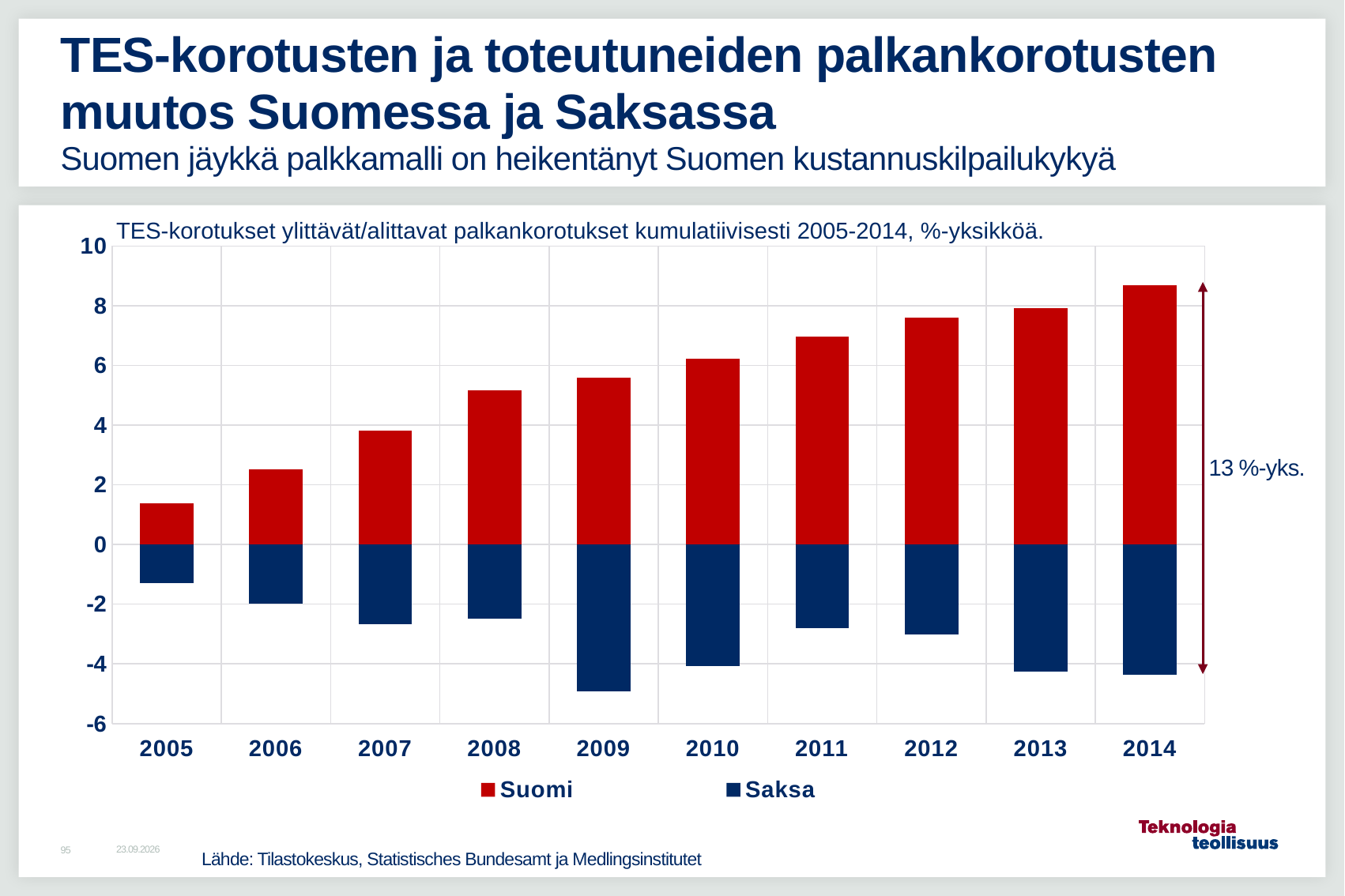
How many years are shown on the x axis of the chart? 10 In which year is the Suomi value highest? 2014 Do the Suomi values rise or fall from 2005 to 2014? rise Is the Suomi value for 2014 greater or less than 8? greater Which is larger, the Suomi value for 2007 or for 2006? 2007 In which year is the Saksa value lowest (most negative)? 2009 How many series does the chart legend list? 2 In which year is the Suomi value lowest? 2005 Is the Suomi value for 2005 greater or less than 2? less What does the arrow annotation on the right side of the chart read? 13 %-yks. Is the Saksa value for 2009 greater or less than -4? less What kind of chart is shown on the slide? bar chart